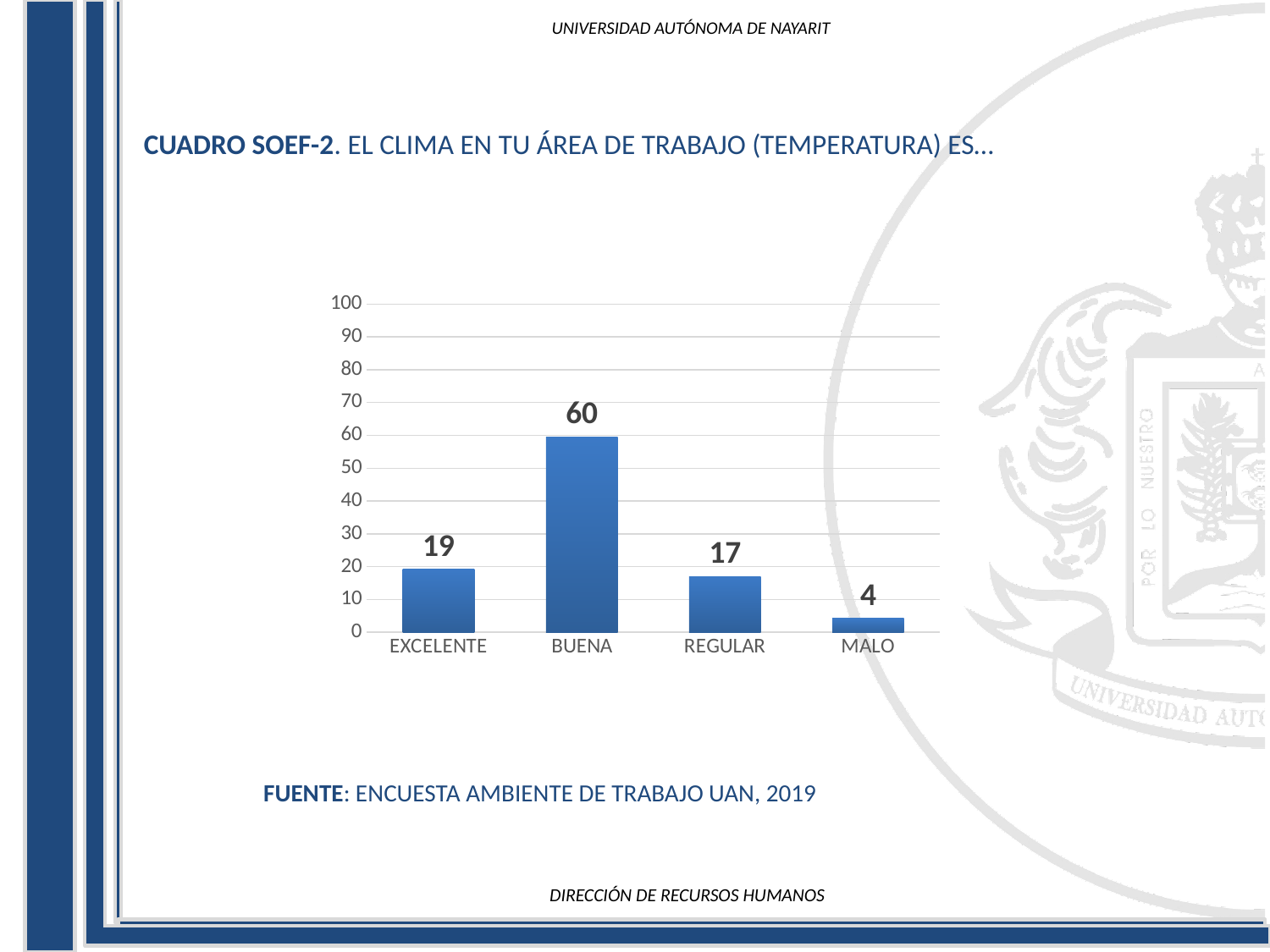
What is the source cited below the chart? ENCUESTA AMBIENTE DE TRABAJO UAN, 2019 How many categories are shown on the x axis? 4 Which is larger, the value for EXCELENTE or the value for REGULAR? EXCELENTE What is the value for MALO? 4 Which category has the highest value? BUENA What is the value for BUENA? 60 Which category has the lowest value? MALO What is the difference between the values for REGULAR and MALO? 13 What is the value for EXCELENTE? 19 What is the difference between the values for BUENA and EXCELENTE? 41 What kind of chart is shown on the slide? bar chart What is the value for REGULAR? 17